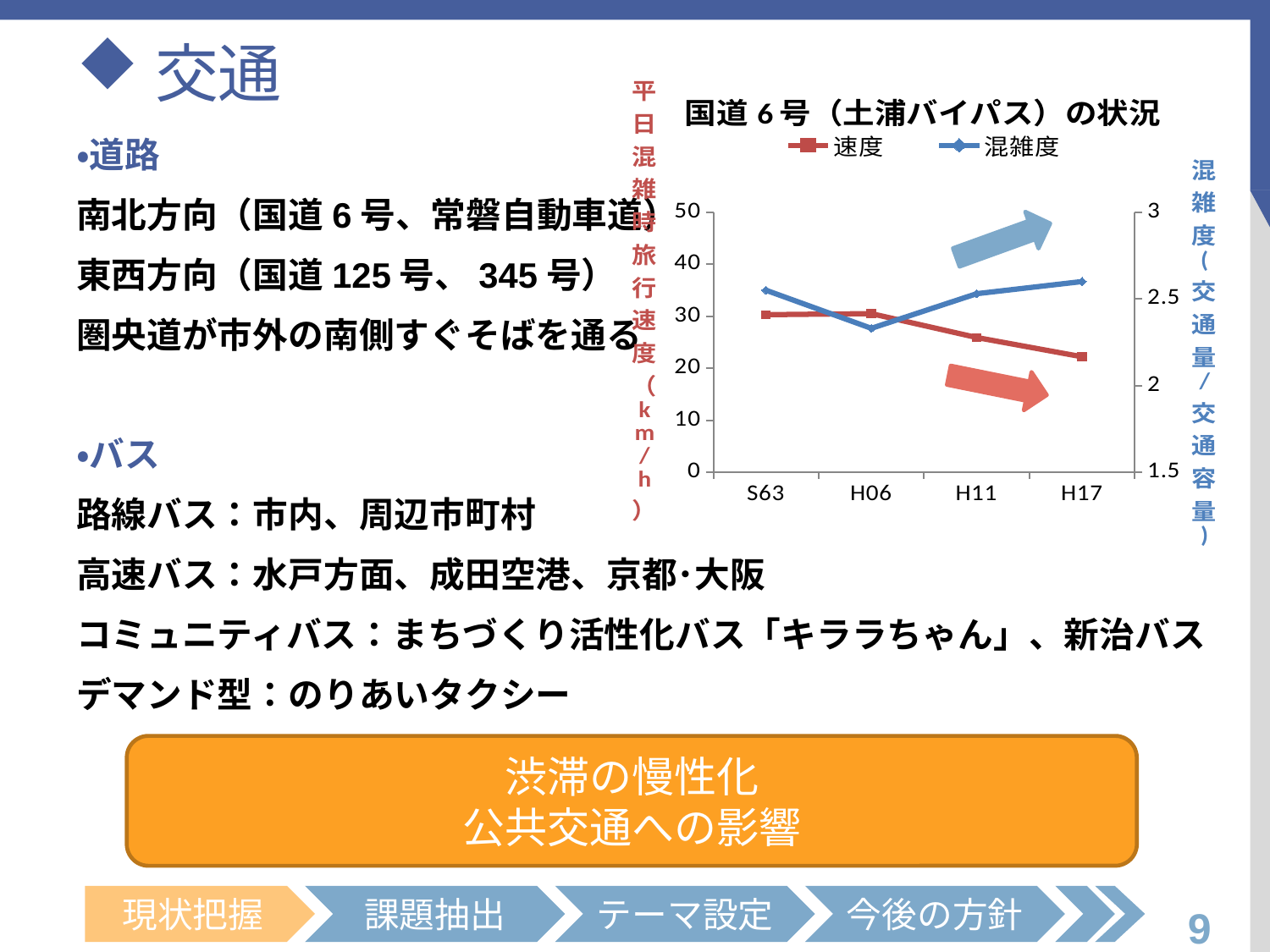
Is the 速度 value for H17 greater or less than 30? less How many categories are shown on the x axis of the chart? 4 Does the 速度 series rise or fall from H06 to H17? fall Which category has the lowest 速度 value? H17 Which series is drawn in red in the chart? 速度 Is the 混雑度 value for H06 greater or less than 2.5? less Which category has the lowest 混雑度 value? H06 Does the 混雑度 series rise or fall from H06 to H17? rise What is the title of the chart? 国道6号（土浦バイパス）の状況 How many series does the chart legend list? 2 What kind of chart is shown on the slide? line chart Is the 速度 value for S63 greater or less than 20? greater